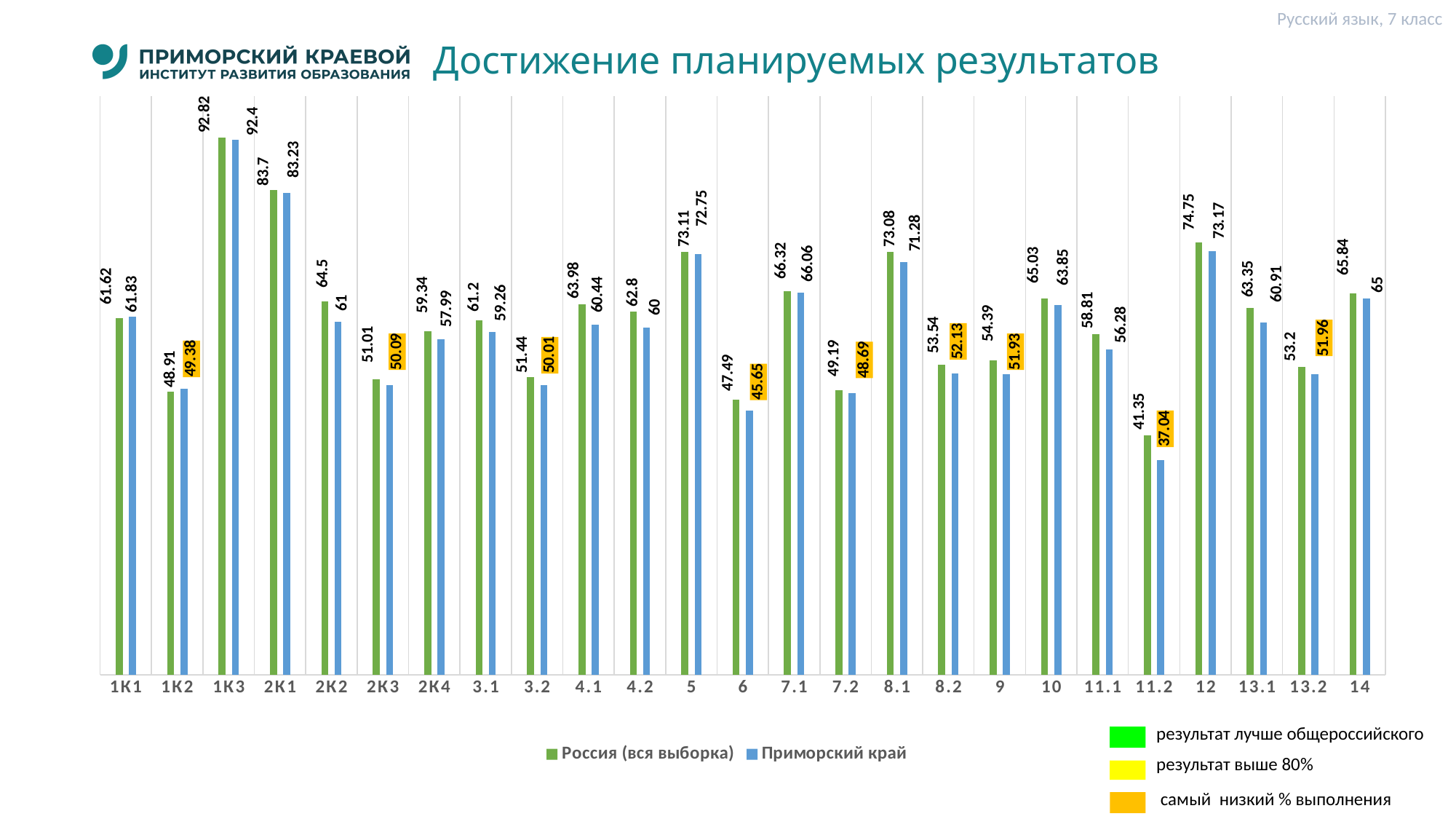
What is the value for Приморский край for category 11.2? 37.04 What is the value for Россия (вся выборка) for category 1К3? 92.82 For category 4.1, which series has the larger value: Россия (вся выборка) or Приморский край? Россия (вся выборка) Which category has the lowest value for Россия (вся выборка)? 11.2 What is the value for Приморский край for category 2К2? 61 How many categories are shown on the x axis of the chart? 25 What is the difference between Россия (вся выборка) and Приморский край for category 2К2? 3.5 What kind of chart is shown on the slide? bar chart Which category has the highest value for Приморский край? 1К3 How many series does the chart legend list? 2 What is the difference between Россия (вся выборка) and Приморский край for category 11.2? 4.31 For category 1К2, which series has the larger value: Россия (вся выборка) or Приморский край? Приморский край